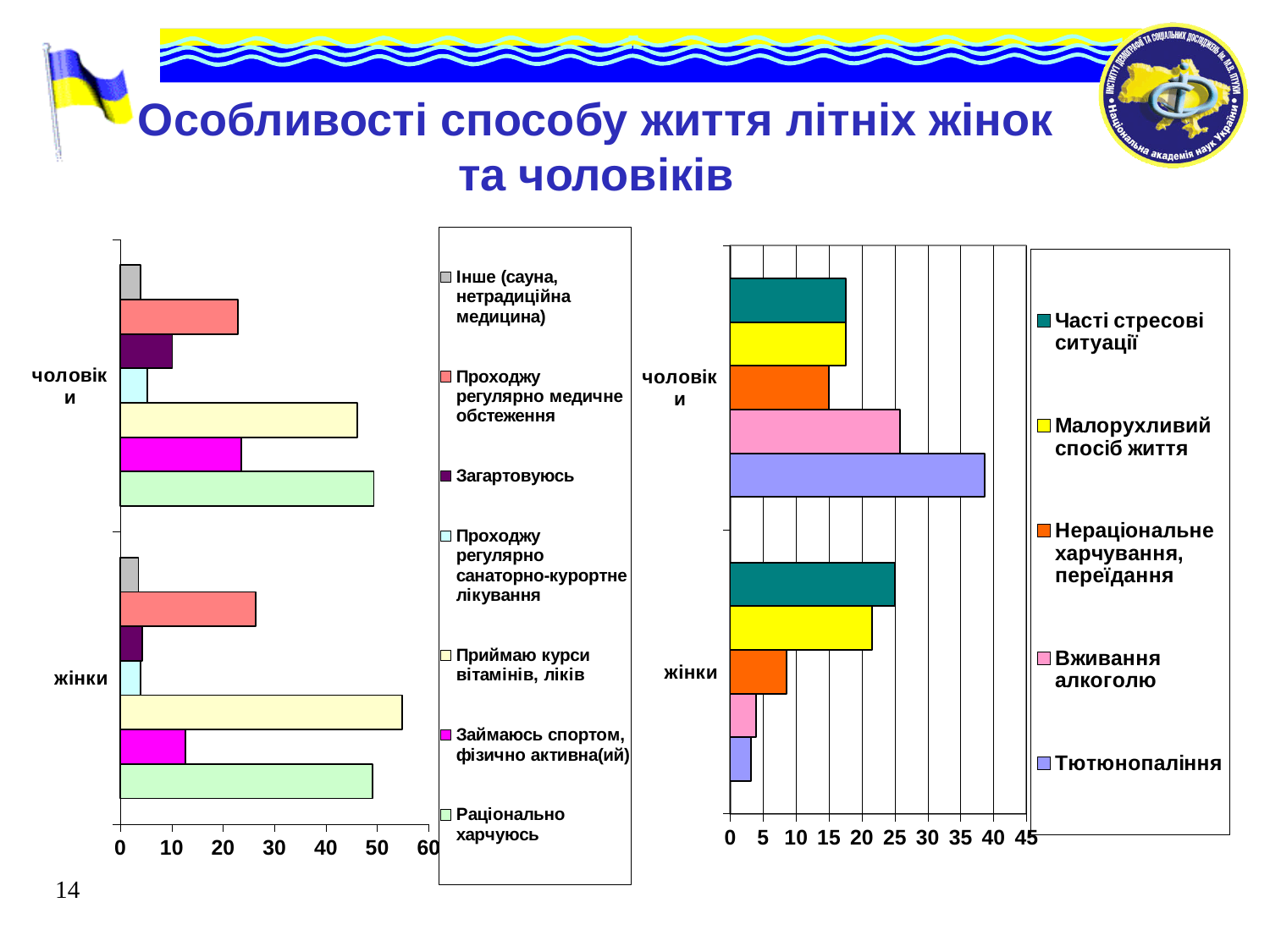
How many categories are shown on the y axis of the right chart? 2 In the left chart, is the value of Приймаю курси вітамінів, ліків for жінки greater or less than 50? greater In the right chart, is the value of Тютюнопаління for жінки greater or less than 5? less What kind of chart is the left chart on the slide? bar chart In the left chart, is the value of Займаюсь спортом, фізично активна(ий) larger for чоловіки or for жінки? чоловіки In the right chart, which series has the highest value for чоловіки? Тютюнопаління How many series does the legend of the right chart list? 5 In the right chart, is the value of Вживання алкоголю larger for чоловіки or for жінки? чоловіки In the right chart, which series has the highest value for жінки? Часті стресові ситуації In the right chart, is the value of Тютюнопаління for чоловіки greater or less than 35? greater What is the maximum value shown on the x axis of the left chart? 60 How many series does the legend of the left chart list? 7